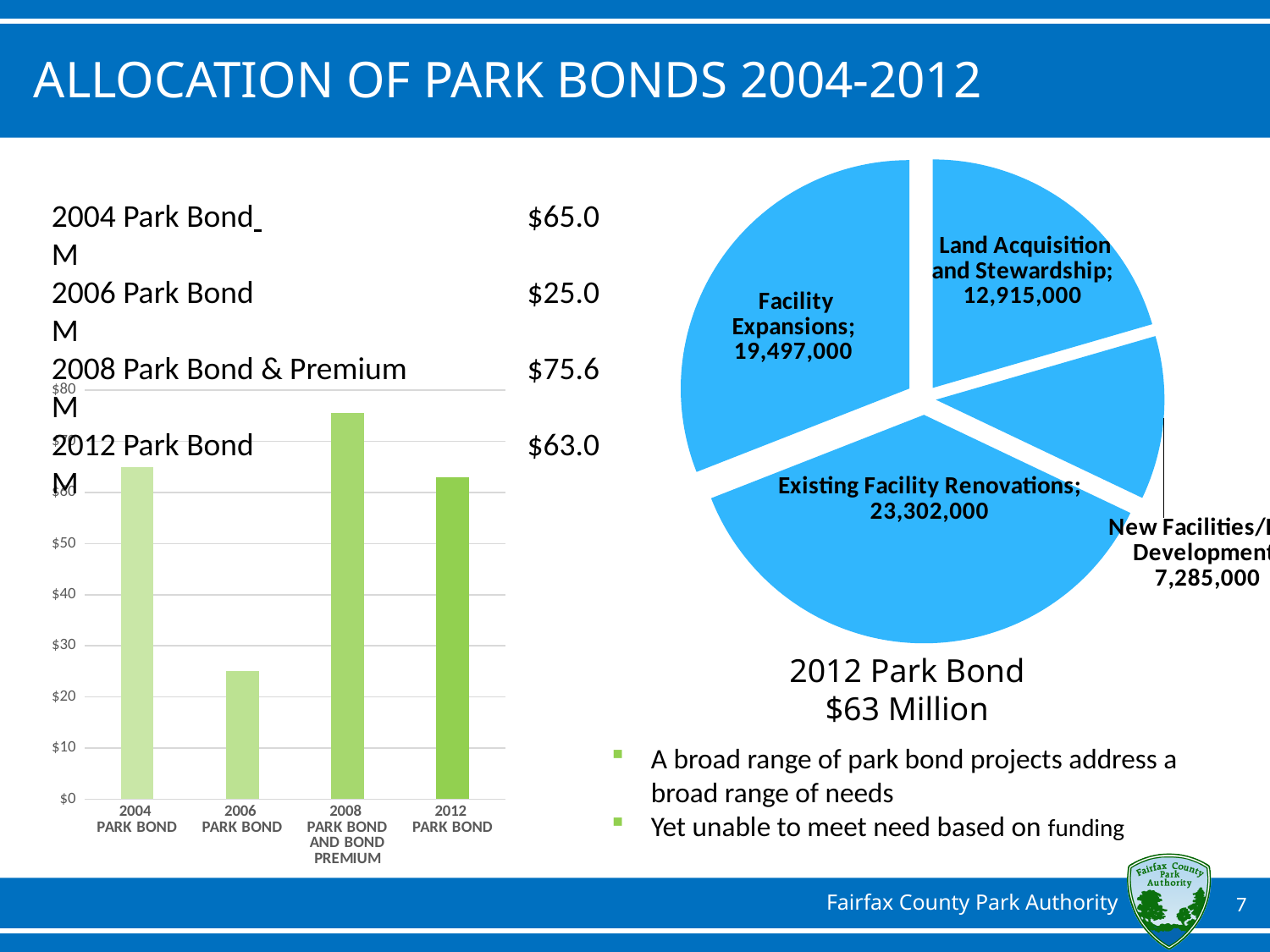
In the pie chart on the right, what is the value for Existing Facility Renovations? 23,302,000 What kind of chart is shown on the left side of the slide? bar chart In the bar chart on the left, is the value for the 2006 Park Bond greater or less than $30? less In the bar chart on the left, which park bond has the shortest bar? 2006 Park Bond In the pie chart on the right, which category has the largest slice? Existing Facility Renovations In the bar chart on the left, which park bond has the tallest bar? 2008 Park Bond and Bond Premium In the bar chart on the left, which bar is taller: 2004 Park Bond or 2012 Park Bond? 2004 Park Bond What kind of chart is shown on the right side of the slide under the title '2012 Park Bond $63 Million'? pie chart In the pie chart on the right, what is the difference between Existing Facility Renovations and Facility Expansions? 3,805,000 In the bar chart on the left, is the value for the 2008 Park Bond and Bond Premium greater or less than $70? greater In the bar chart on the left, how many bars are plotted? 4 In the pie chart on the right, what is the value for Land Acquisition and Stewardship? 12,915,000